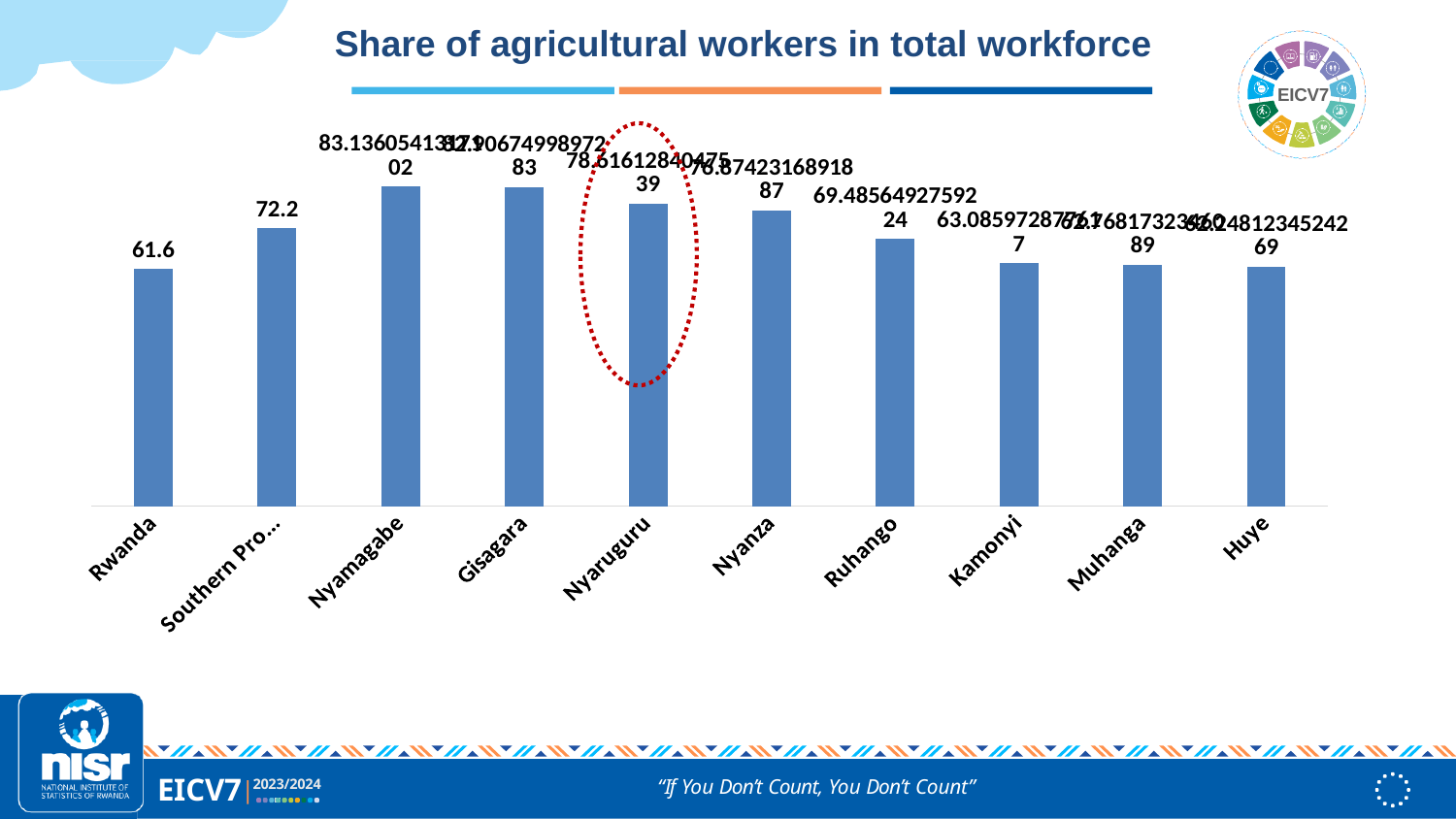
Which is larger, the value for Nyaruguru or the value for Huye? Nyaruguru What type of chart is shown on the slide? bar chart Which is larger, the value for Nyanza or the value for Kamonyi? Nyanza What is the value shown for Rwanda? 61.6 What is the title of the chart? Share of agricultural workers in total workforce How many categories (bars) are plotted in the chart? 10 Which is larger, the value for Rwanda or the value for Southern Pro...? Southern Pro... What is the value shown for the second bar from the left (Southern Pro...)? 72.2 Which category's bar is highlighted with a red dotted circle? Nyaruguru What is the difference between the value for Southern Pro... and the value for Rwanda? 10.6